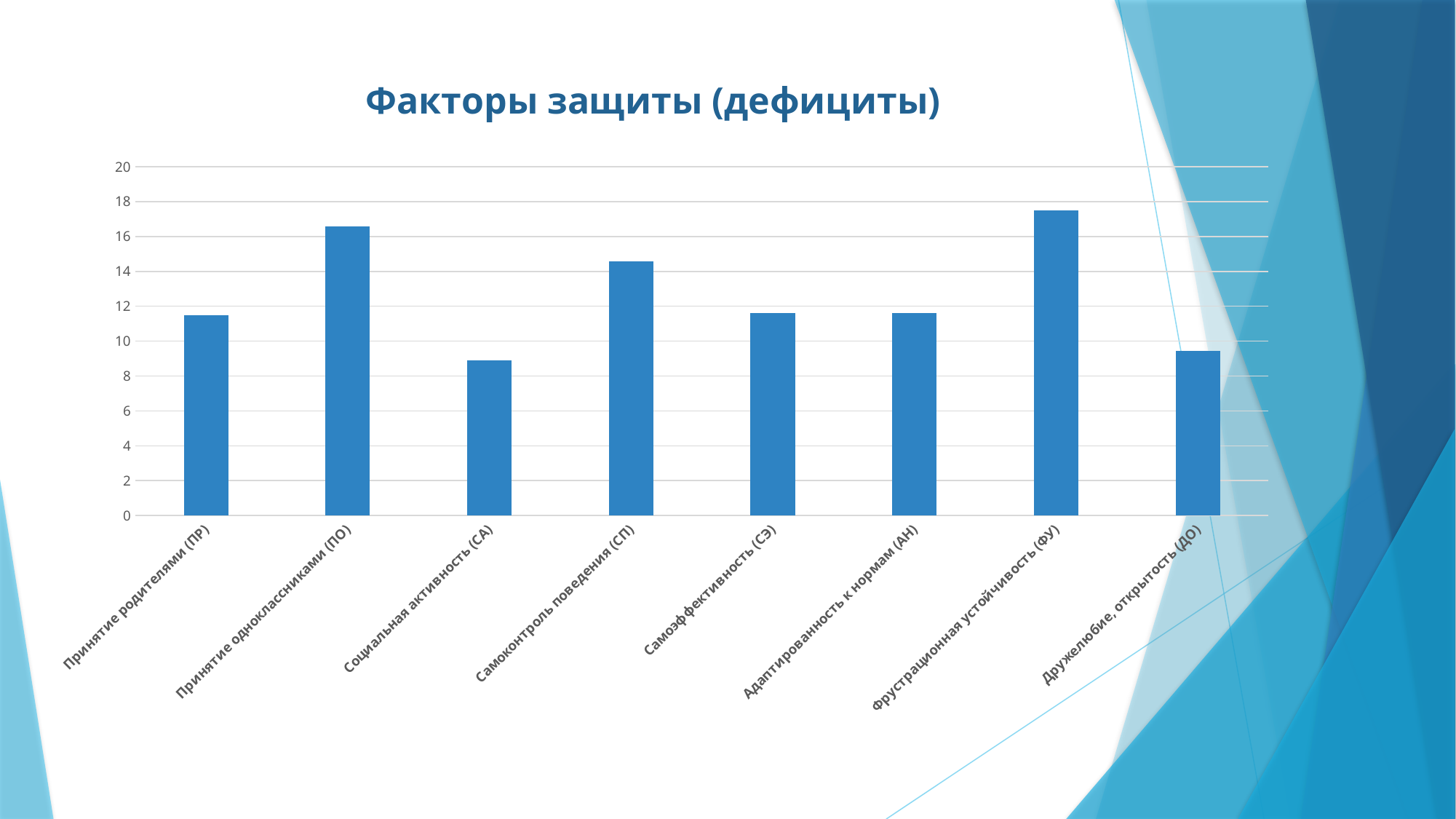
Which is larger: the value for Принятие одноклассниками (ПО) or for Самоконтроль поведения (СП)? Принятие одноклассниками (ПО) Is the value for Социальная активность (СА) greater or less than 10? less Which is larger: the value for Фрустрационная устойчивость (ФУ) or for Принятие родителями (ПР)? Фрустрационная устойчивость (ФУ) What is the title of the chart? Факторы защиты (дефициты) Which category has the highest bar? Фрустрационная устойчивость (ФУ) Which is larger: the value for Социальная активность (СА) or for Самоконтроль поведения (СП)? Самоконтроль поведения (СП) What kind of chart is shown on the slide? bar chart Is the value for Самоконтроль поведения (СП) greater or less than 14? greater How many categories are plotted in the chart? 8 Is the value for Дружелюбие, открытость (ДО) greater or less than 10? less